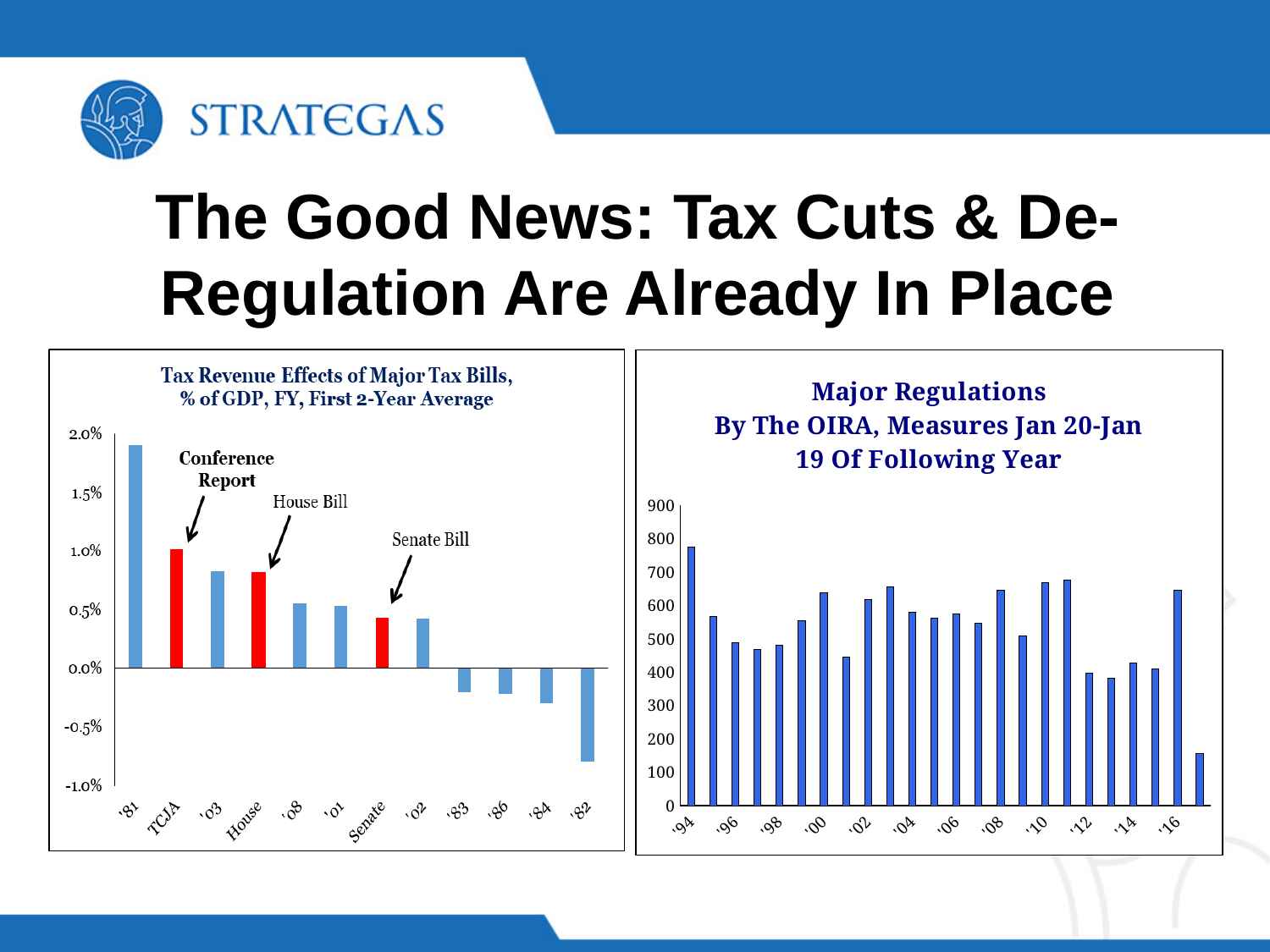
On the left chart (Tax Revenue Effects of Major Tax Bills), is the value for '81 greater or less than 1.5%? greater On the right chart (Major Regulations By The OIRA), which year has the highest value? '94 On the left chart (Tax Revenue Effects of Major Tax Bills), what kind of chart is shown? bar chart On the left chart (Tax Revenue Effects of Major Tax Bills), how many bars are plotted? 12 On the left chart (Tax Revenue Effects of Major Tax Bills), what annotation label points to the TCJA bar? Conference Report On the left chart (Tax Revenue Effects of Major Tax Bills), which category has the highest value? '81 On the left chart (Tax Revenue Effects of Major Tax Bills), which bars are coloured red? TCJA, House, Senate On the left chart (Tax Revenue Effects of Major Tax Bills), which is larger, the value for '81 or the value for TCJA? '81 On the right chart (Major Regulations By The OIRA), is the value for '12 greater or less than 500? less On the left chart (Tax Revenue Effects of Major Tax Bills), which category has the lowest value? '82 On the left chart (Tax Revenue Effects of Major Tax Bills), is the value for TCJA greater or less than 1.5%? less